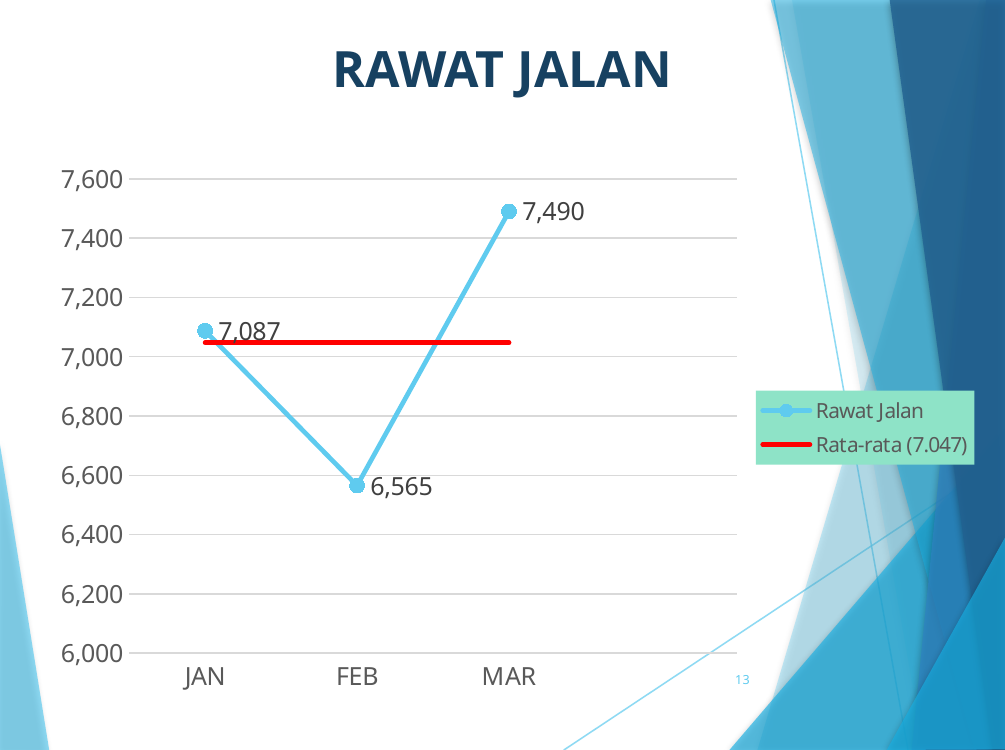
How many series does the legend list? 2 Which month has the lowest Rawat Jalan value? FEB What is the Rawat Jalan value for MAR? 7,490 Which is larger, the Rawat Jalan value for JAN or for MAR? MAR Is the Rawat Jalan value for FEB greater or less than 6,800? less Which month has the highest Rawat Jalan value? MAR How many months are plotted on the x axis? 3 What kind of chart is shown on the slide? line chart What is the Rawat Jalan value for FEB? 6,565 What is the Rawat Jalan value for JAN? 7,087 What is the difference between the Rawat Jalan values for JAN and FEB? 522 What is the difference between the Rawat Jalan values for MAR and FEB? 925